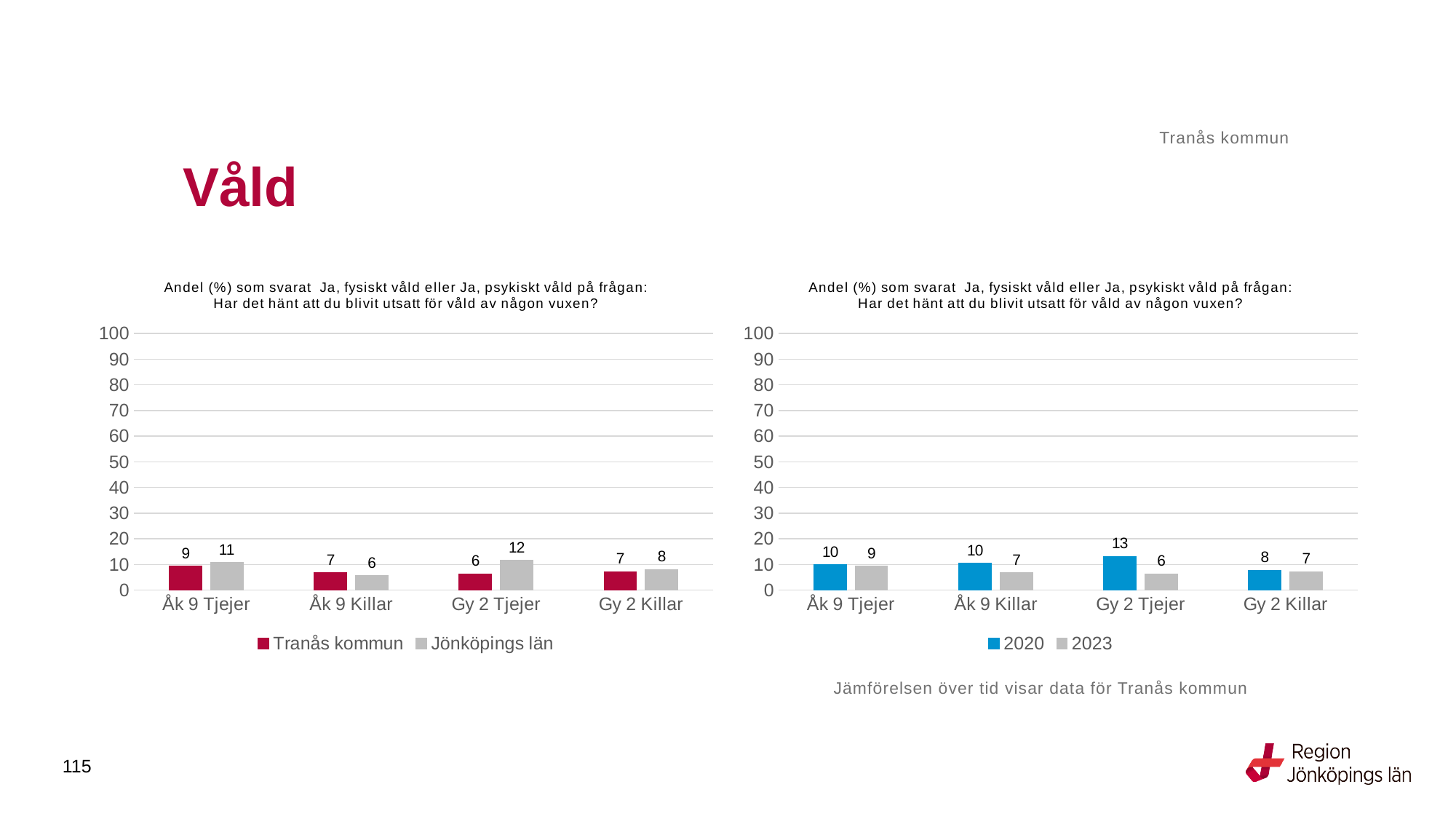
In the left chart, which is larger for Gy 2 Tjejer: Tranås kommun or Jönköpings län? Jönköpings län In the right chart, what is the difference between the 2020 and 2023 values for Gy 2 Tjejer? 7 In the left chart, what is the value for Jönköpings län for Gy 2 Tjejer? 12 In the right chart, what is the value for 2023 for Åk 9 Killar? 7 How many series does the legend of the right chart list? 2 In the right chart, what is the value for 2020 for Gy 2 Tjejer? 13 In the right chart, which category has the lowest value for 2023? Gy 2 Tjejer What kind of chart is the left chart? bar chart In the left chart, which category has the highest value for Jönköpings län? Gy 2 Tjejer In the left chart, what is the value for Tranås kommun for Åk 9 Tjejer? 9 How many categories are shown on the x axis of the left chart? 4 In the right chart, is the value for 2020 for Åk 9 Tjejer greater or less than 20? less